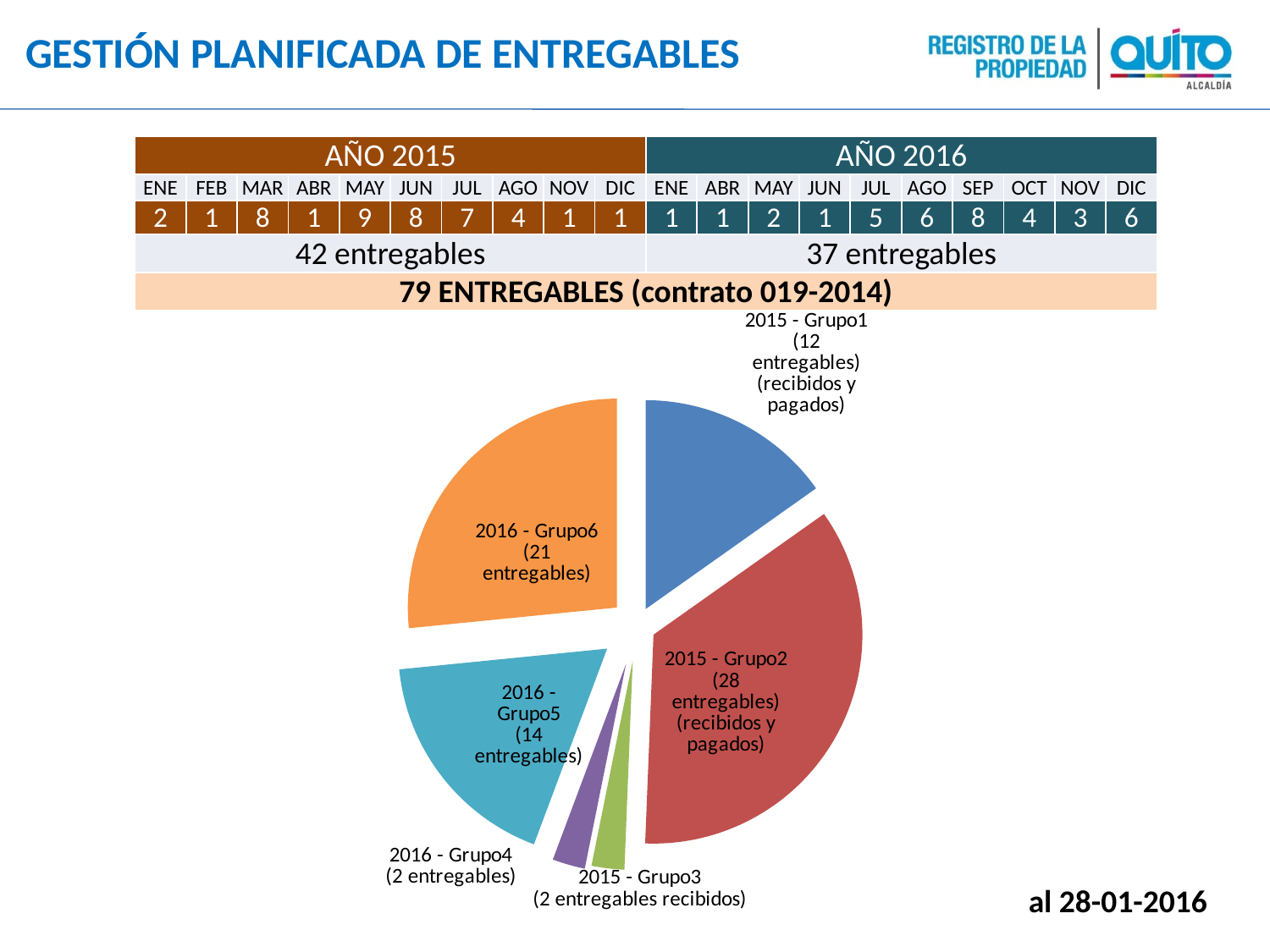
How many entregables does the 2016 - Grupo5 slice represent? 14 entregables How many entregables does the 2015 - Grupo1 slice represent? 12 entregables What is the difference in entregables between 2015 - Grupo2 and 2016 - Grupo6? 7 What kind of chart is shown on the slide? pie chart How many entregables does the 2015 - Grupo2 slice represent? 28 entregables What is the total number of entregables across all slices of the pie chart? 79 Which slice is larger, 2016 - Grupo5 or 2015 - Grupo1? 2016 - Grupo5 What colour is the 2015 - Grupo2 slice? red How many entregables does the 2016 - Grupo6 slice represent? 21 entregables How many slices does the pie chart have? 6 How many entregables does the 2016 - Grupo4 slice represent? 2 entregables Which group has the largest slice in the pie chart? 2015 - Grupo2